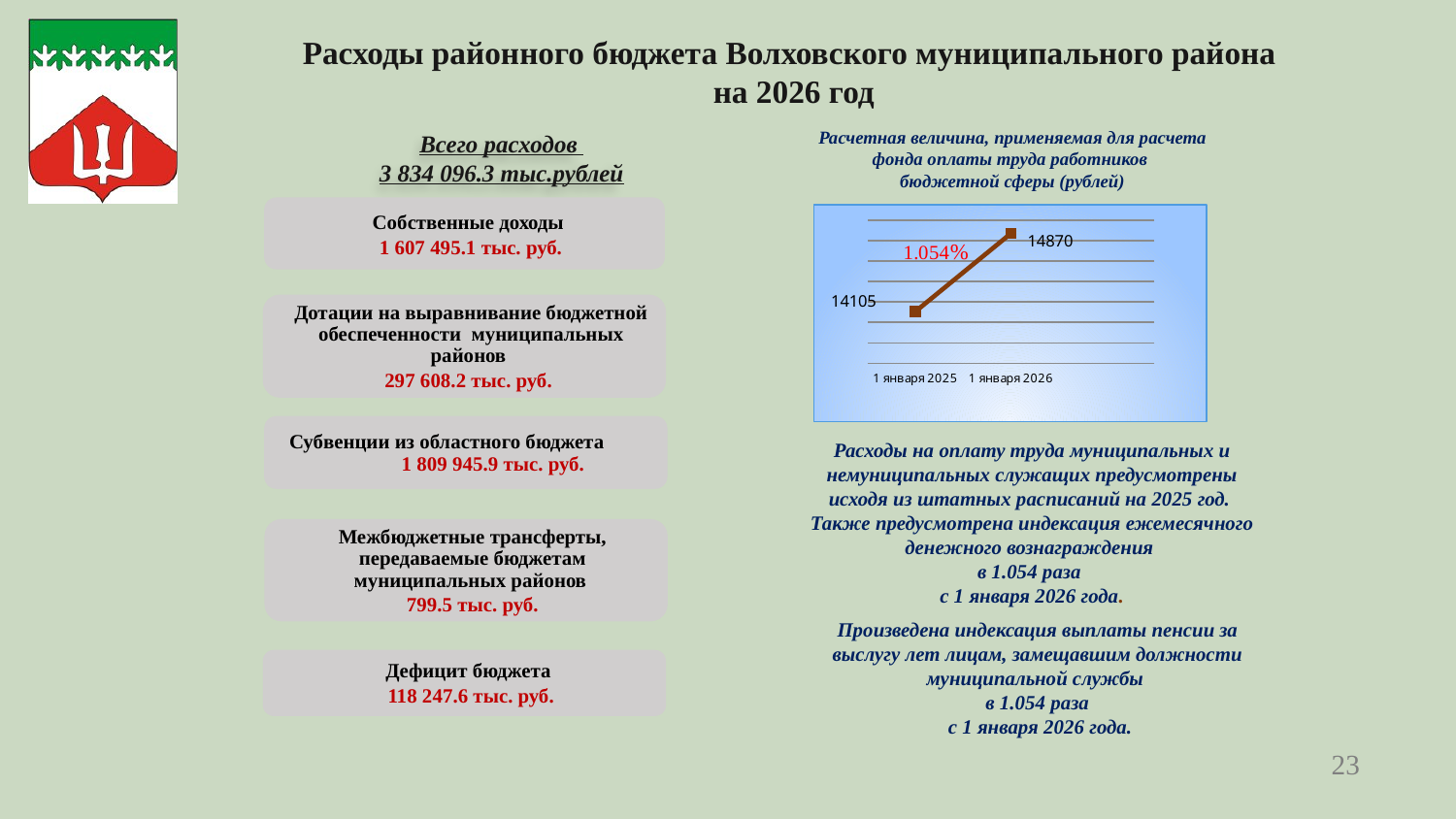
Is the value for 1 января 2026 larger or smaller than the value for 1 января 2025? larger What unit is given in parentheses in the chart's title? рублей What kind of chart is shown on the slide? line chart What percentage label is written next to the line on the chart? 1.054% Which date has the lower value on the chart? 1 января 2025 What is the difference between the values for 1 января 2026 and 1 января 2025? 765 Does the value rise or fall from 1 января 2025 to 1 января 2026? rise Which date has the higher value on the chart? 1 января 2026 How many data points are plotted on the chart? 2 What is the value for 1 января 2025 on the chart? 14105 What is the value for 1 января 2026 on the chart? 14870